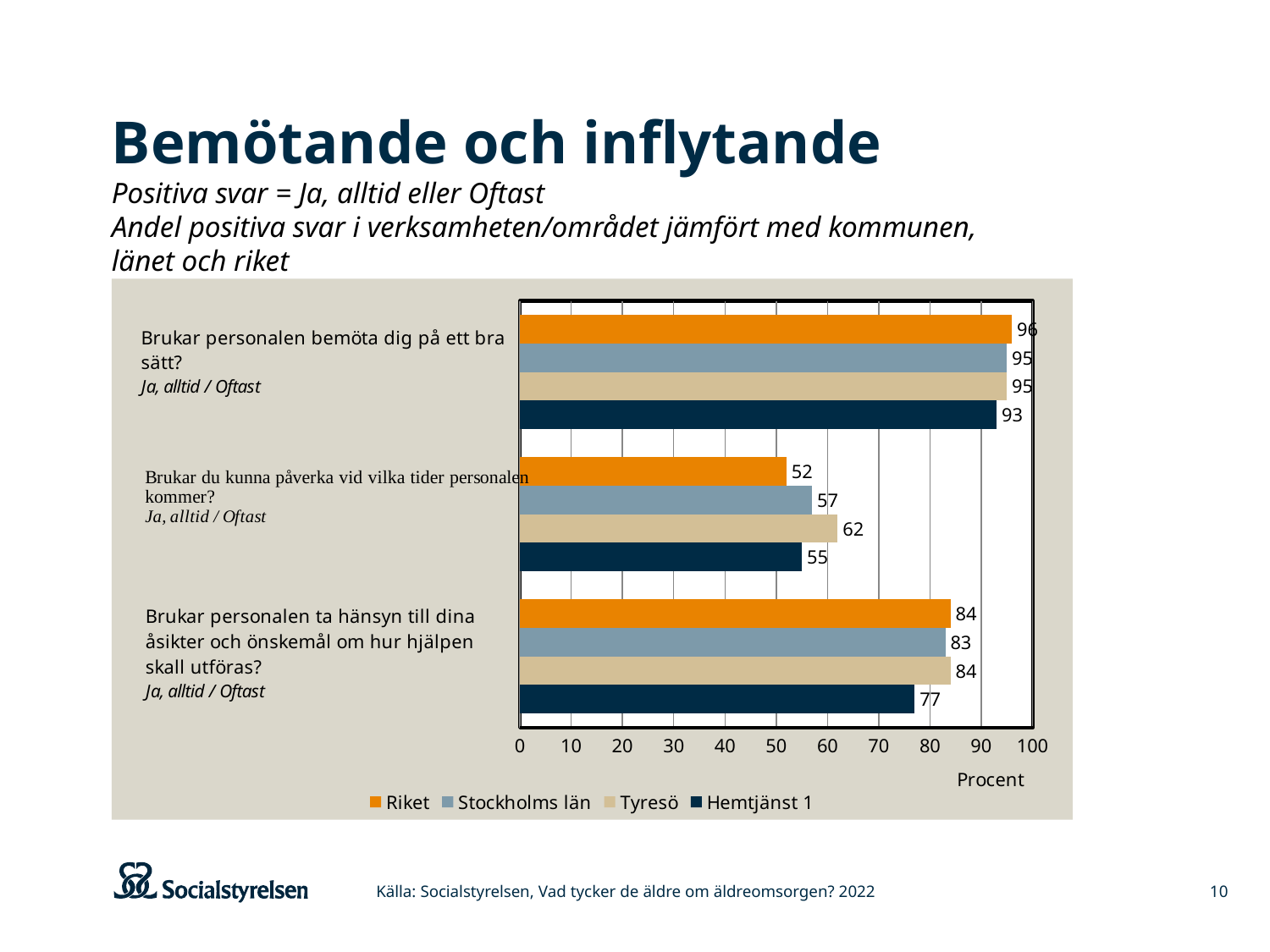
What is the value for Riket on the question "Brukar personalen ta hänsyn till dina åsikter och önskemål om hur hjälpen skall utföras?"? 84 What is the difference between Tyresö and Riket on the question "Brukar du kunna påverka vid vilka tider personalen kommer?"? 10 Which series has the highest value on the question "Brukar du kunna påverka vid vilka tider personalen kommer?"? Tyresö How many series does the legend list? 4 What type of chart is shown on the slide? Bar chart What is the value for Hemtjänst 1 on the question "Brukar personalen bemöta dig på ett bra sätt?"? 93 Which is larger on the question "Brukar personalen ta hänsyn till dina åsikter och önskemål om hur hjälpen skall utföras?": Stockholms län or Hemtjänst 1? Stockholms län Is the value for Hemtjänst 1 on the question "Brukar du kunna påverka vid vilka tider personalen kommer?" greater or less than 60? less How many question categories are plotted on the chart? 3 What is the value for Tyresö on the question "Brukar du kunna påverka vid vilka tider personalen kommer?"? 62 What label is shown on the horizontal axis of the chart? Procent Which series has the lowest value on the question "Brukar personalen ta hänsyn till dina åsikter och önskemål om hur hjälpen skall utföras?"? Hemtjänst 1